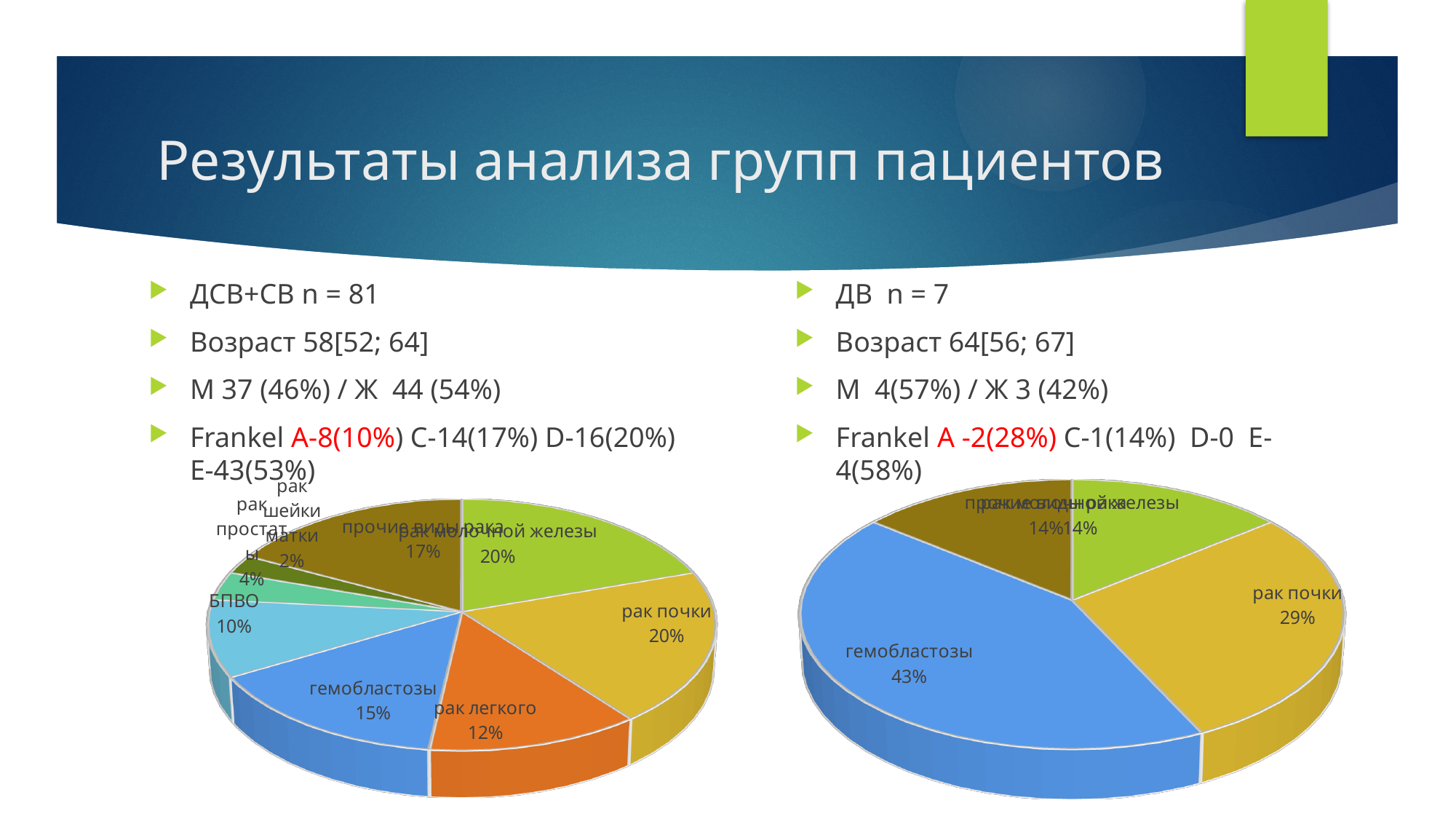
In the right pie chart, which category has the largest slice? гемобластозы In the right pie chart, how many percentage points larger is гемобластозы than рак почки? 14 percentage points In the left pie chart, what share is shown for гемобластозы? 15% In the left pie chart, which is larger: рак молочной железы or рак легкого? рак молочной железы In the left pie chart, what share is shown for прочие виды рака? 17% In the left pie chart, how many percentage points larger is рак почки than рак легкого? 8 percentage points In the left pie chart, which category has the smallest slice? рак шейки матки In the left pie chart, what share is shown for рак легкого? 12% In the left pie chart, what share is shown for БПВО? 10% How many slices does the left pie chart have? 8 In the right pie chart, what share is shown for рак почки? 29% What kind of chart is the left chart on the slide? Pie chart